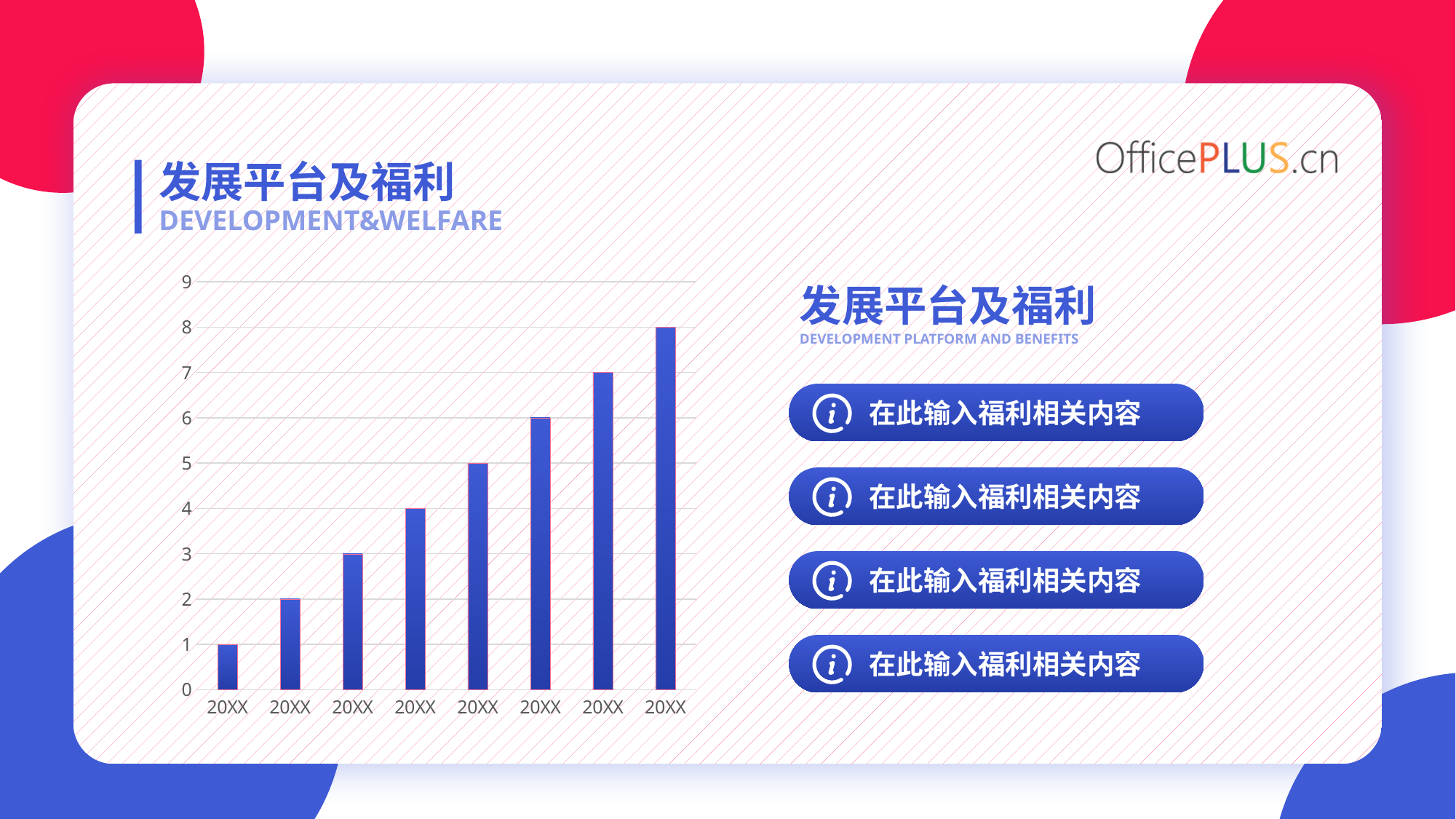
What is the value of the sixth bar from the left? 6 What is the value of the leftmost bar in the chart? 1 What is the value of the fourth bar from the left? 4 What is the value of the rightmost bar in the chart? 8 What is the difference between the rightmost bar and the leftmost bar? 7 Which is larger, the third bar from the left or the seventh bar from the left? the seventh bar Do the bar values rise or fall from left to right along the x axis? rise What label is shown under every bar on the x axis? 20XX Which bar is the tallest in the chart? the rightmost bar What kind of chart is shown on the slide? bar chart How many bars does the chart have? 8 Which bar is the shortest in the chart? the leftmost bar